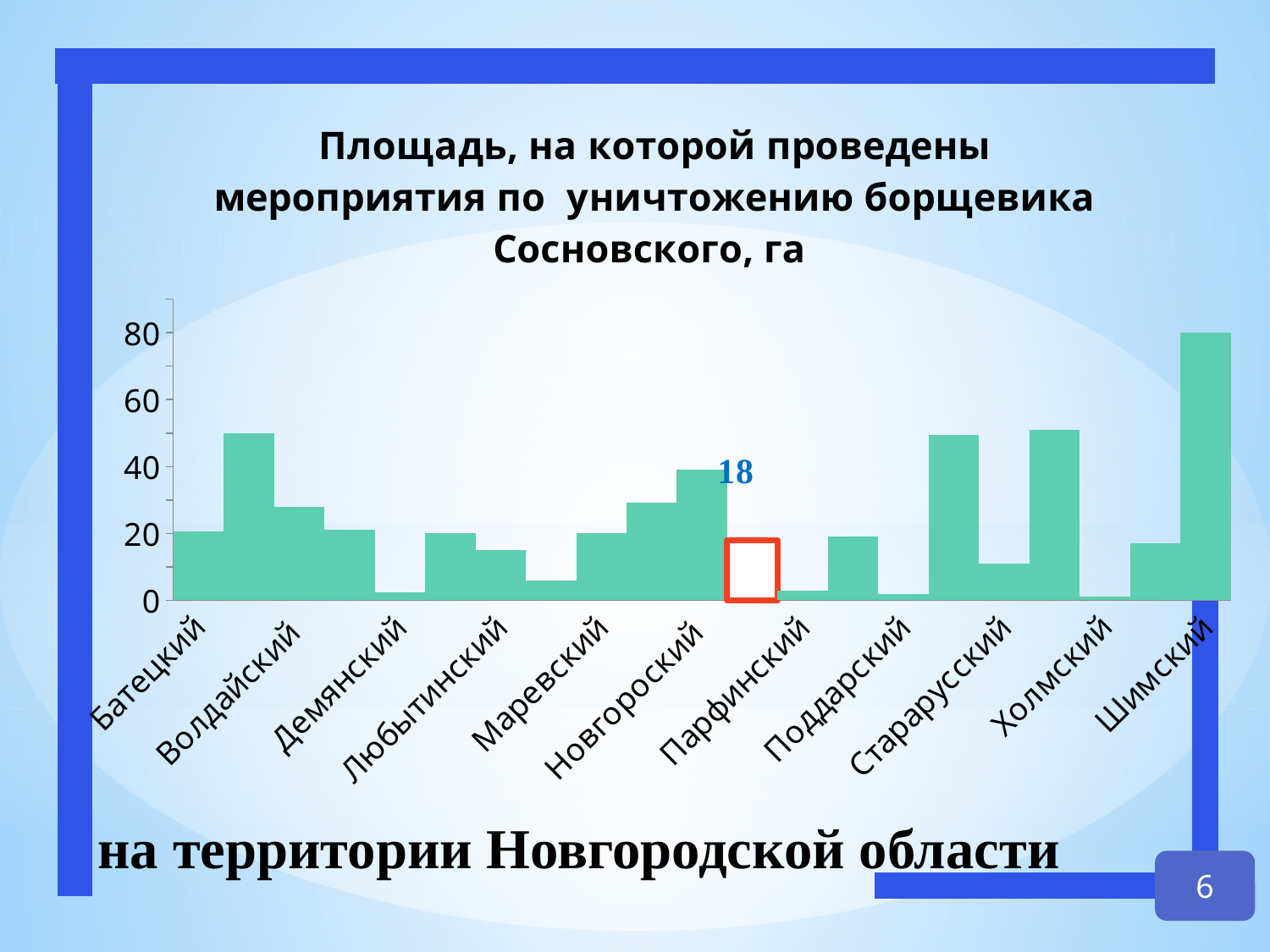
Which has the larger value, Новгороский or Демянский? Новгороский Is the value for Новгороский greater or less than 20? greater What is the highest value shown on the vertical axis of the chart? 80 Is the value for Шимский greater or less than 60? greater How many district labels are shown on the x axis of the chart? 11 Is the value for Холмский greater or less than 20? less Which labeled district has the highest value in the chart? Шимский What is the title of the chart? Площадь, на которой проведены мероприятия по уничтожению борщевика Сосновского, га What kind of chart is shown on the slide? bar chart Which has the larger value, Шимский or Батецкий? Шимский